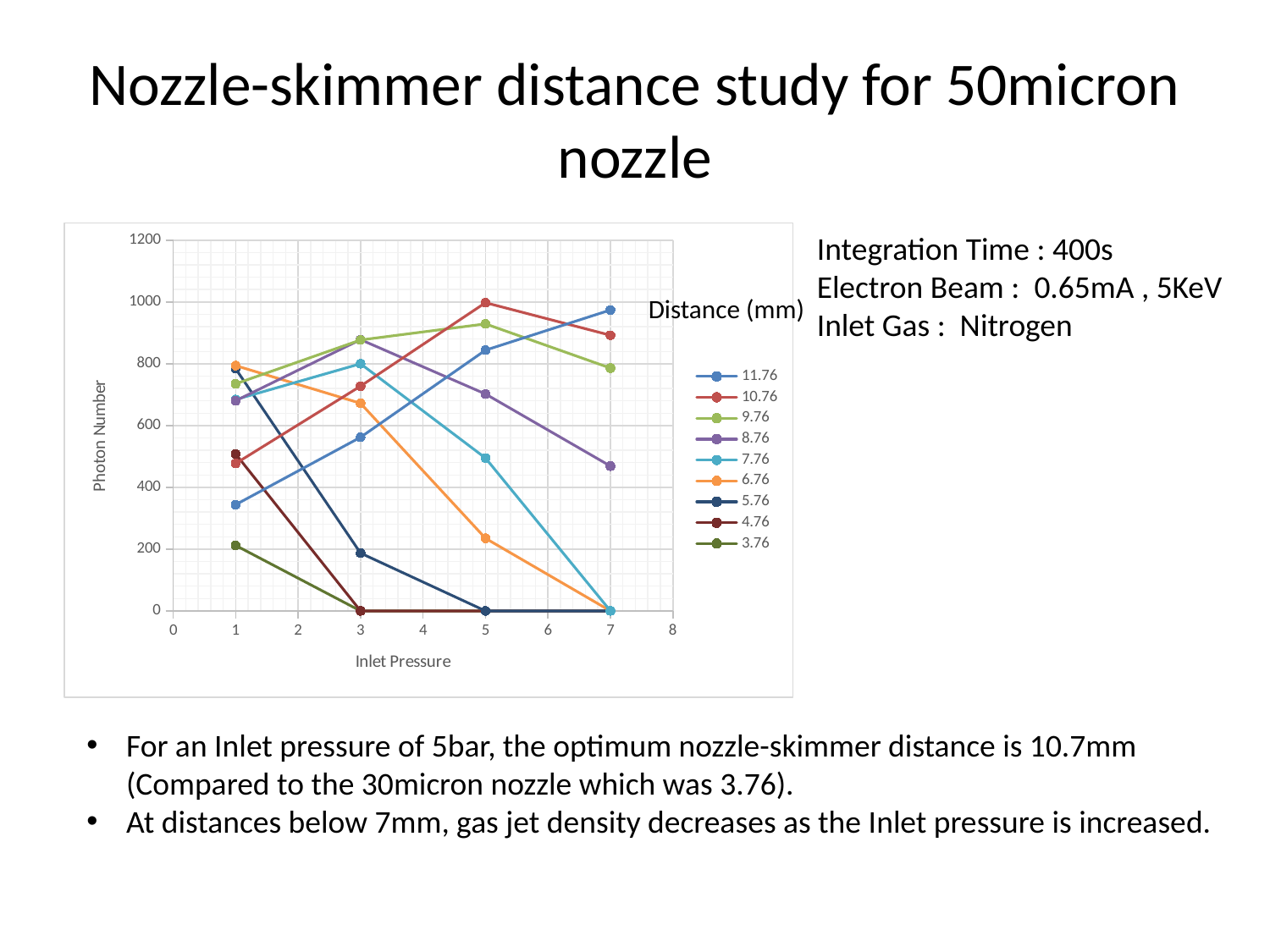
Is the Photon Number for the 9.76 series at an Inlet Pressure of 5 greater or less than 800? greater How many data points are plotted for the 11.76 series? 4 Which series has the highest Photon Number at an Inlet Pressure of 7? 11.76 Is the Photon Number for the 8.76 series at an Inlet Pressure of 7 greater or less than 600? less How many series does the chart legend list? 9 Does the Photon Number for the 11.76 series rise or fall as Inlet Pressure increases? rise What is the title of the chart legend? Distance (mm) At an Inlet Pressure of 3, which series has the larger Photon Number, 9.76 or 11.76? 9.76 What is the label of the vertical axis of the chart? Photon Number What kind of chart is shown on the slide? line chart Which series has the lowest Photon Number at an Inlet Pressure of 1? 3.76 Is the Photon Number for the 11.76 series at an Inlet Pressure of 1 greater or less than 400? less